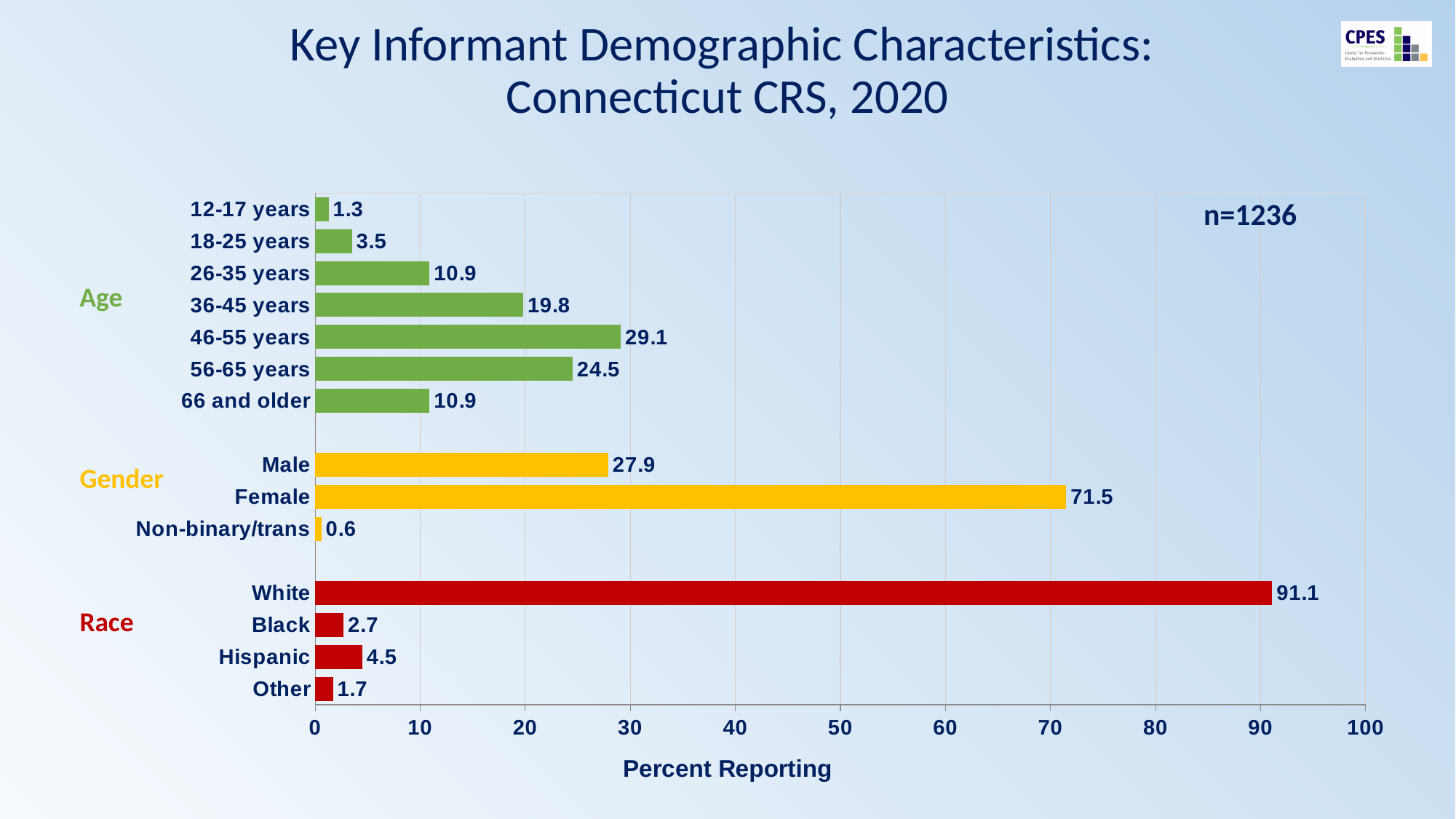
What is the label of the horizontal axis? Percent Reporting What is the difference between the values for Female and Male? 43.6 What is the value for the 46-55 years age group? 29.1 Which is larger, the value for Male or the value for 46-55 years? 46-55 years Which category has the lowest value on the chart? Non-binary/trans Which category has the highest value on the chart? White How many age group categories are shown on the chart? 7 What kind of chart is shown on the slide? Bar chart Which age group has the highest value? 46-55 years What is the value for Hispanic? 4.5 What is the difference between the values for 46-55 years and 56-65 years? 4.6 What is the value for Female? 71.5